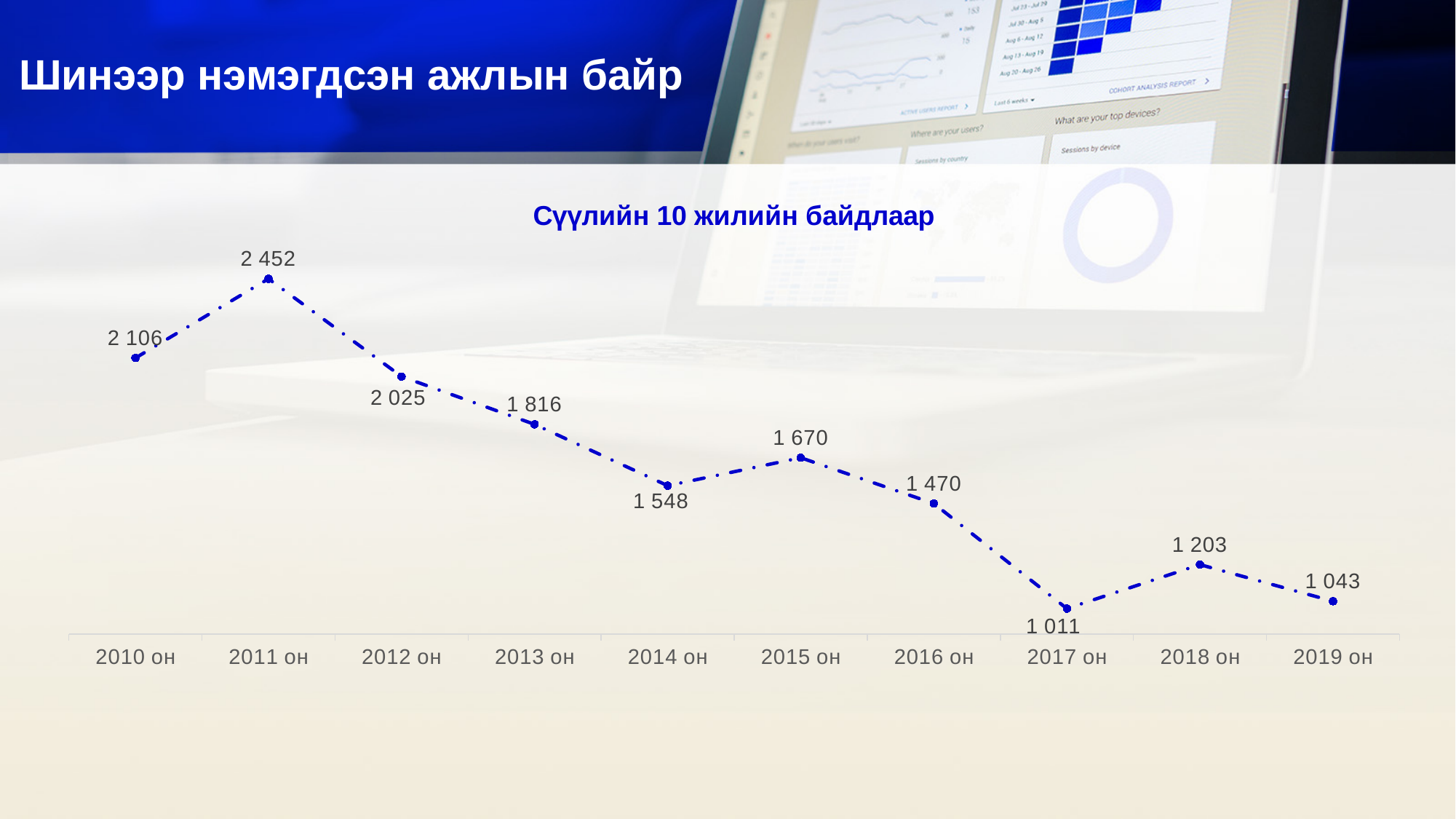
Which year has the highest value? 2011 он Which is larger, the value for 2015 он or the value for 2016 он? 2015 он Do the values generally rise or fall from 2011 он to 2019 он? Fall What is the difference between the values for 2011 он and 2012 он? 427 What kind of chart is shown on the slide? Line chart What is the value for 2014 он? 1 548 How many years are plotted on the chart? 10 What is the value for 2011 он? 2 452 What is the subtitle shown above the chart? Сүүлийн 10 жилийн байдлаар What is the value for 2017 он? 1 011 Which year has the lowest value? 2017 он What is the difference between the values for 2010 он and 2019 он? 1 063